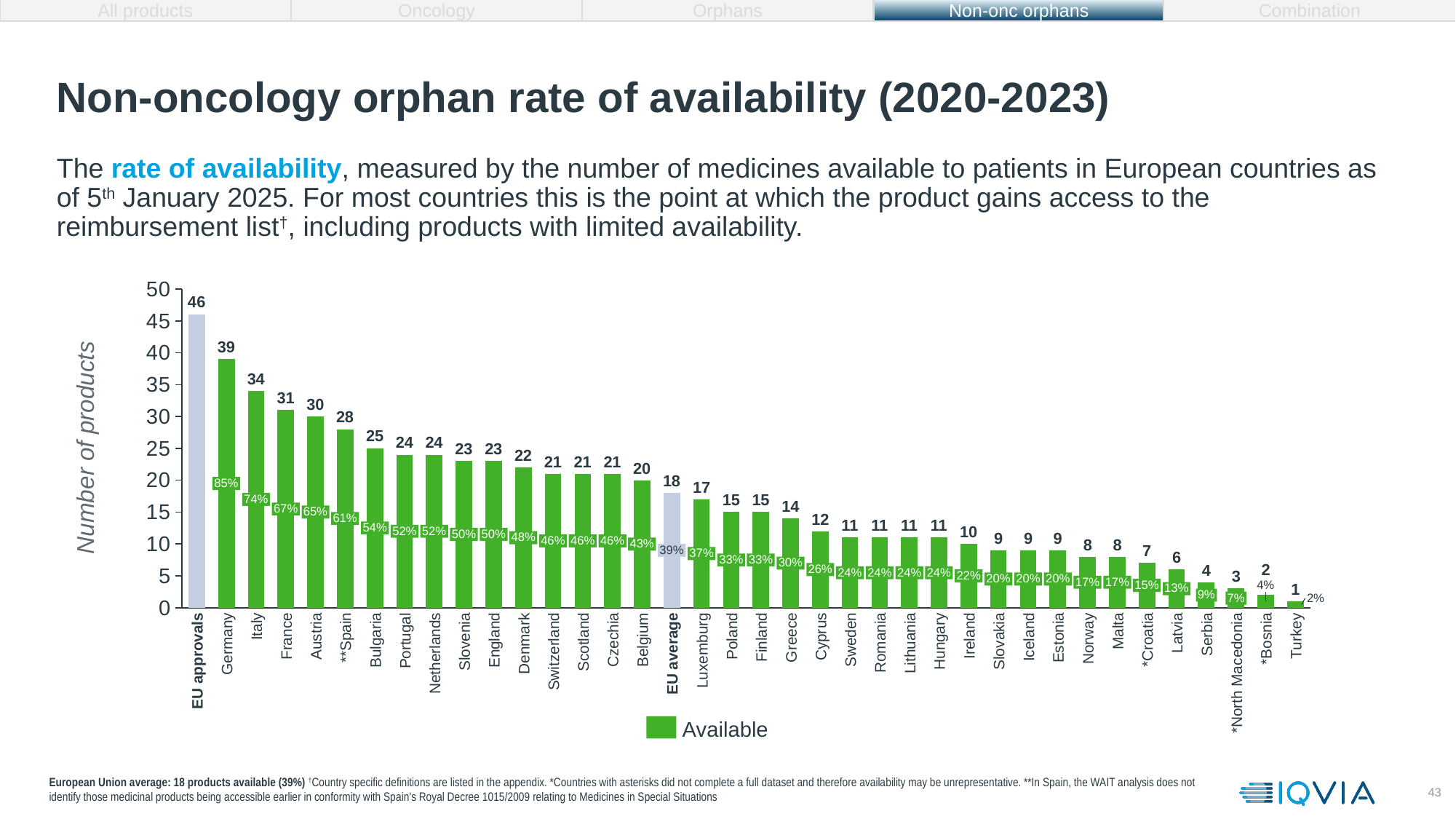
What is the difference in number of products between France and Austria? 1 How many products are shown for Germany? 39 How many bars are plotted on the chart? 38 What kind of chart is shown on the slide? Bar chart Do the values rise or fall moving from left to right along the x axis? Fall How many entries does the legend list? 1 What percentage is shown for Belgium? 43% What percentage is shown on the bar for Italy? 74% Which bar has the highest value on the chart? EU approvals Which country has the lowest number of products? Turkey What is the value for EU average? 18 Which has more products, Luxembourg or Greece? Luxembourg